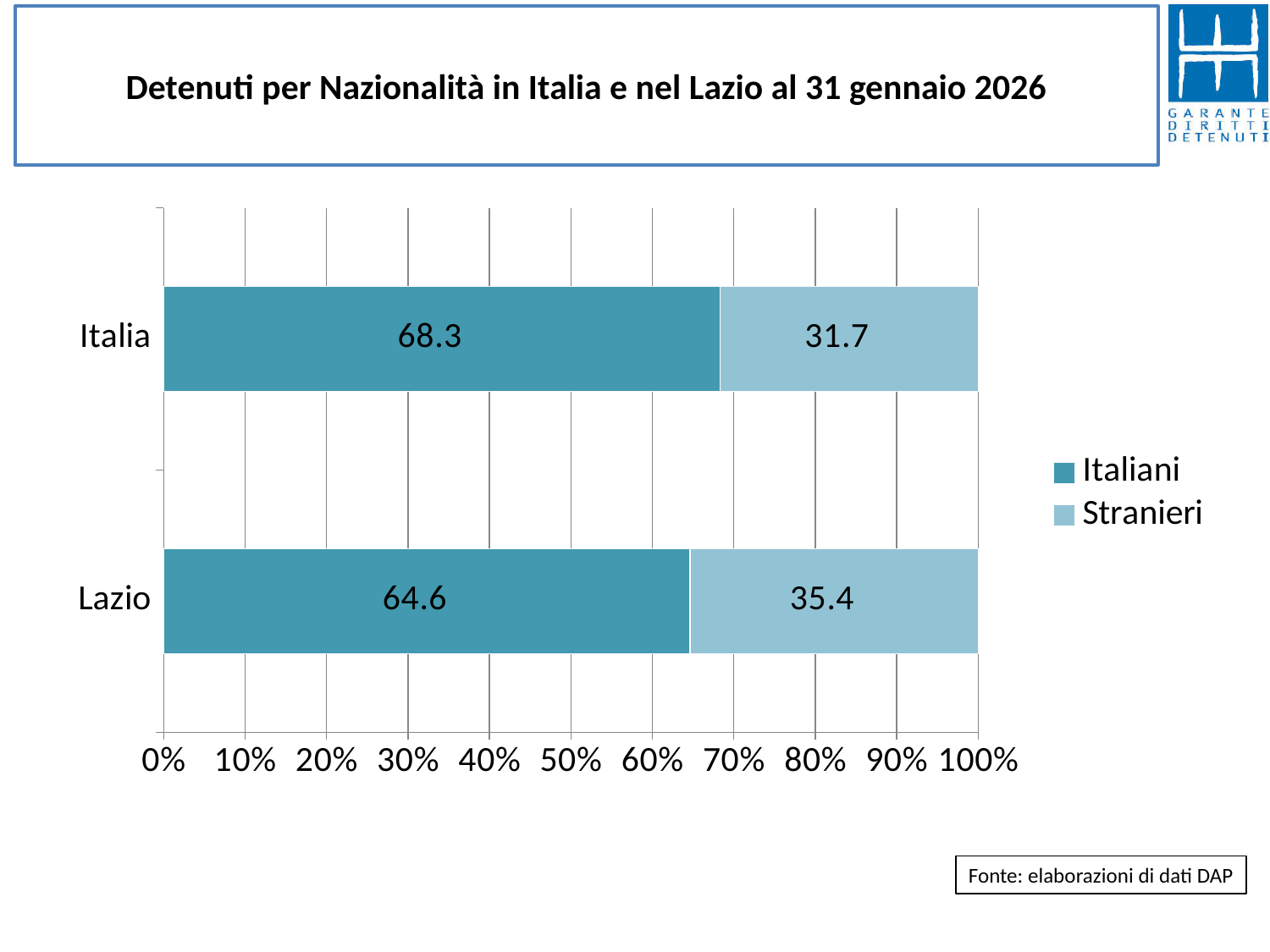
What is the value for Stranieri in Italia? 31.7 What is the value for Italiani in Lazio? 64.6 What is the difference between the Stranieri values for Lazio and Italia? 3.7 What is the difference between the Italiani values for Italia and Lazio? 3.7 Which category has the higher Stranieri value? Lazio How many series does the legend list? 2 What is the value for Stranieri in Lazio? 35.4 What is the value for Italiani in Italia? 68.3 Which category has the higher Italiani value, Italia or Lazio? Italia How many categories are shown on the y axis? 2 What is the title of the chart? Detenuti per Nazionalità in Italia e nel Lazio al 31 gennaio 2026 What kind of chart is shown on the slide? Stacked bar chart